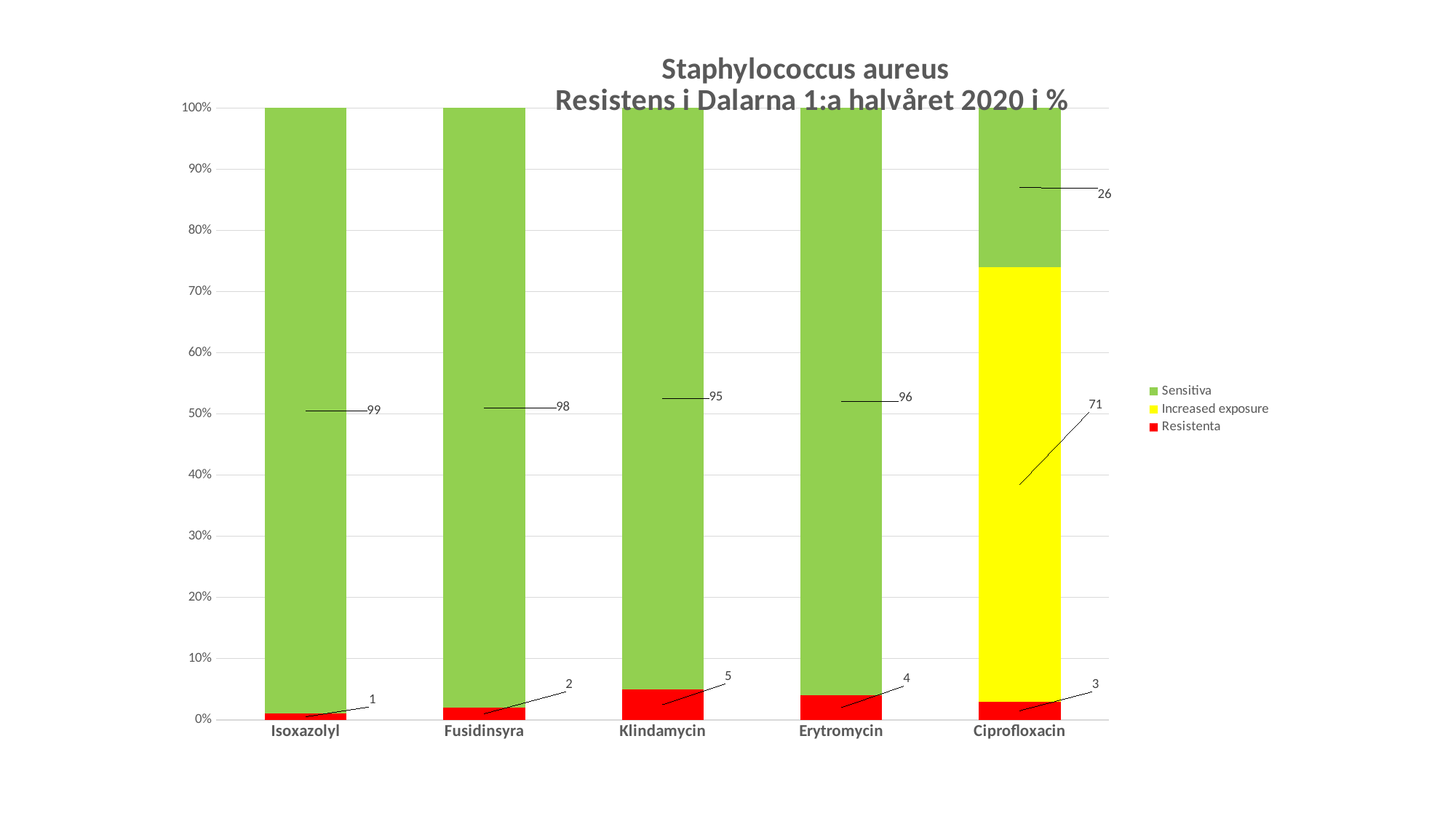
How many series does the legend list? 3 Which antibiotic has the highest Resistenta value? Klindamycin What is the Sensitiva value for Klindamycin? 95 What is the Increased exposure value for Ciprofloxacin? 71 What is the difference between the Sensitiva values for Isoxazolyl and Ciprofloxacin? 73 Is the Sensitiva segment for Ciprofloxacin greater or less than 50%? less What is the Resistenta value for Erytromycin? 4 What kind of chart is shown on the slide? Stacked bar chart Which colour represents the Increased exposure series? Yellow Which is larger, the Resistenta value for Fusidinsyra or for Klindamycin? Klindamycin Which antibiotic has the lowest Sensitiva value? Ciprofloxacin How many antibiotics are shown on the x axis? 5